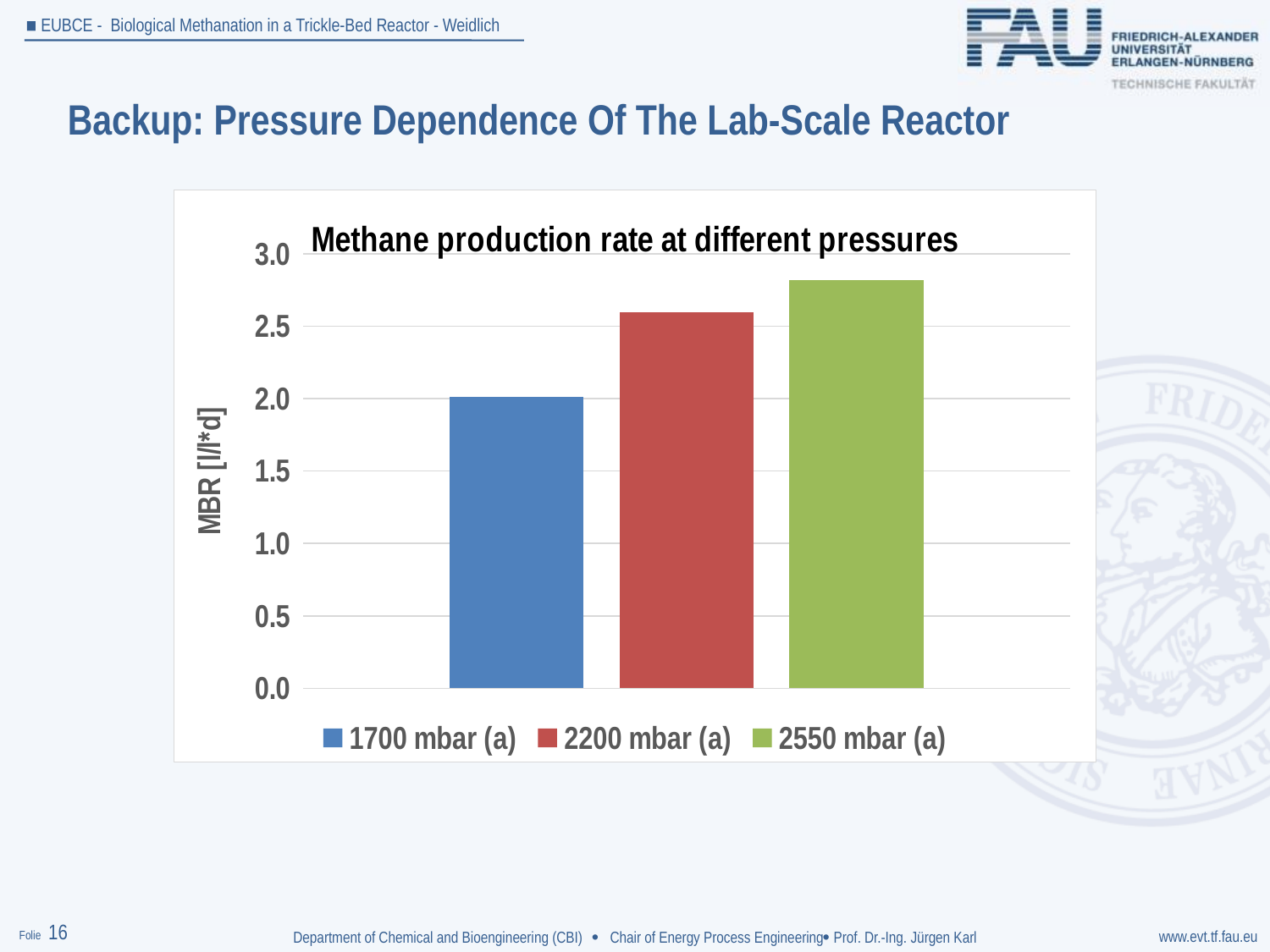
How many series does the legend list? 3 Is the value for 2200 mbar (a) greater or less than 2.5? greater Which pressure has the highest methane production rate? 2550 mbar (a) How many bars are plotted in the chart? 3 What is the label of the vertical axis? MBR [l/l*d] Which pressure has the lowest methane production rate? 1700 mbar (a) What kind of chart is shown on the slide? bar chart Which is larger, the MBR at 2200 mbar (a) or at 1700 mbar (a)? 2200 mbar (a) Does the methane production rate rise or fall as the pressure increases from 1700 to 2550 mbar (a)? rise What is the title of the chart? Methane production rate at different pressures Is the value for 1700 mbar (a) greater or less than 2.5? less Is the value for 2550 mbar (a) greater or less than 3.0? less